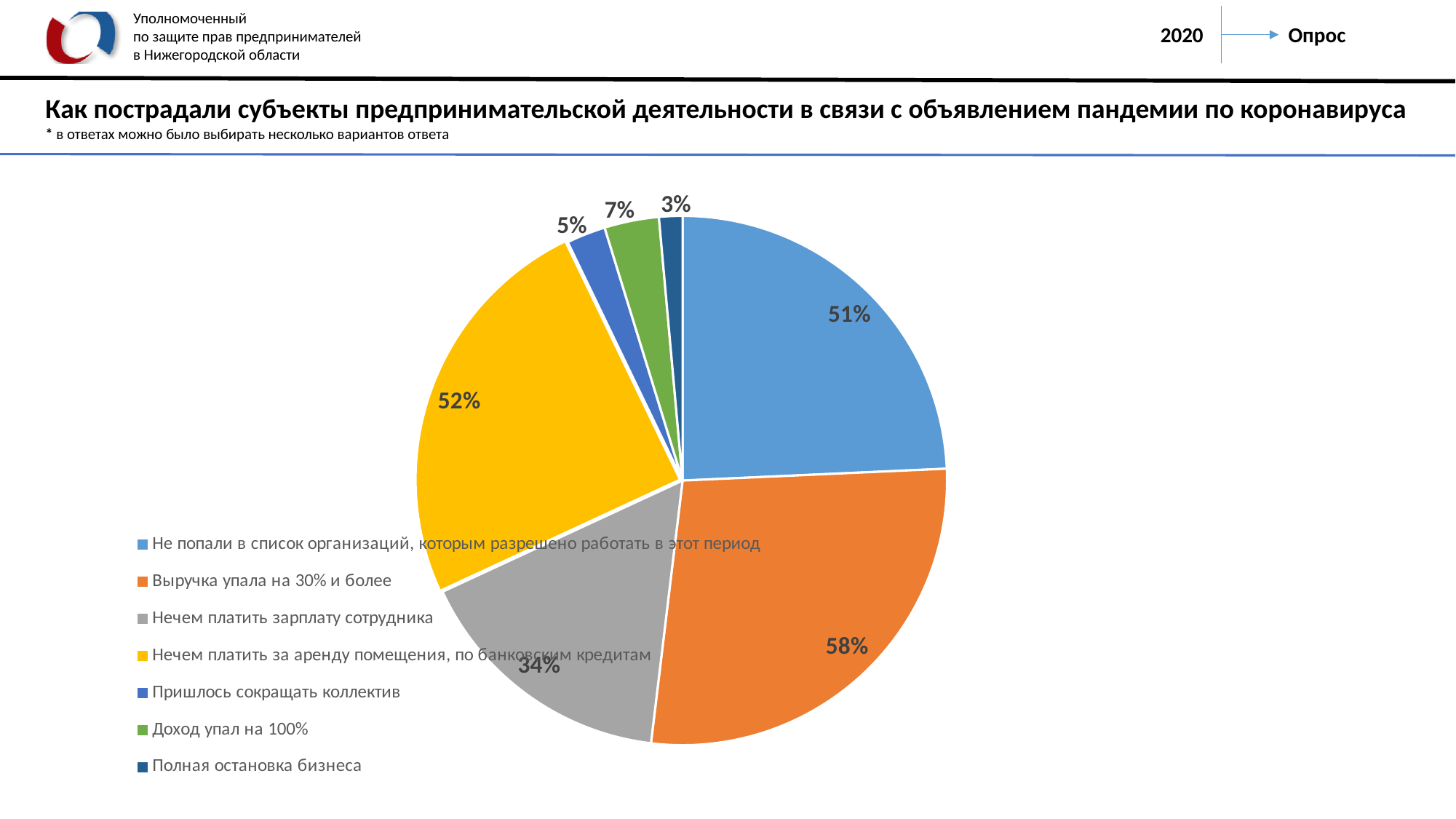
What colour is the slice for "Нечем платить за аренду помещения, по банковским кредитам"? yellow Which is larger: the value for "Доход упал на 100%" or the value for "Пришлось сокращать коллектив"? Доход упал на 100% What is the value for "Нечем платить за аренду помещения, по банковским кредитам"? 52% What kind of chart is shown on the slide? pie chart What is the difference between the values for "Выручка упала на 30% и более" and "Нечем платить зарплату сотрудника"? 24% What is the value for "Полная остановка бизнеса"? 3% How many categories does the pie chart have? 7 What is the value for "Не попали в список организаций, которым разрешено работать в этот период"? 51% Which category has the lowest value? Полная остановка бизнеса Which category has the highest value? Выручка упала на 30% и более What is the value for "Нечем платить зарплату сотрудника"? 34% What is the value for "Выручка упала на 30% и более"? 58%